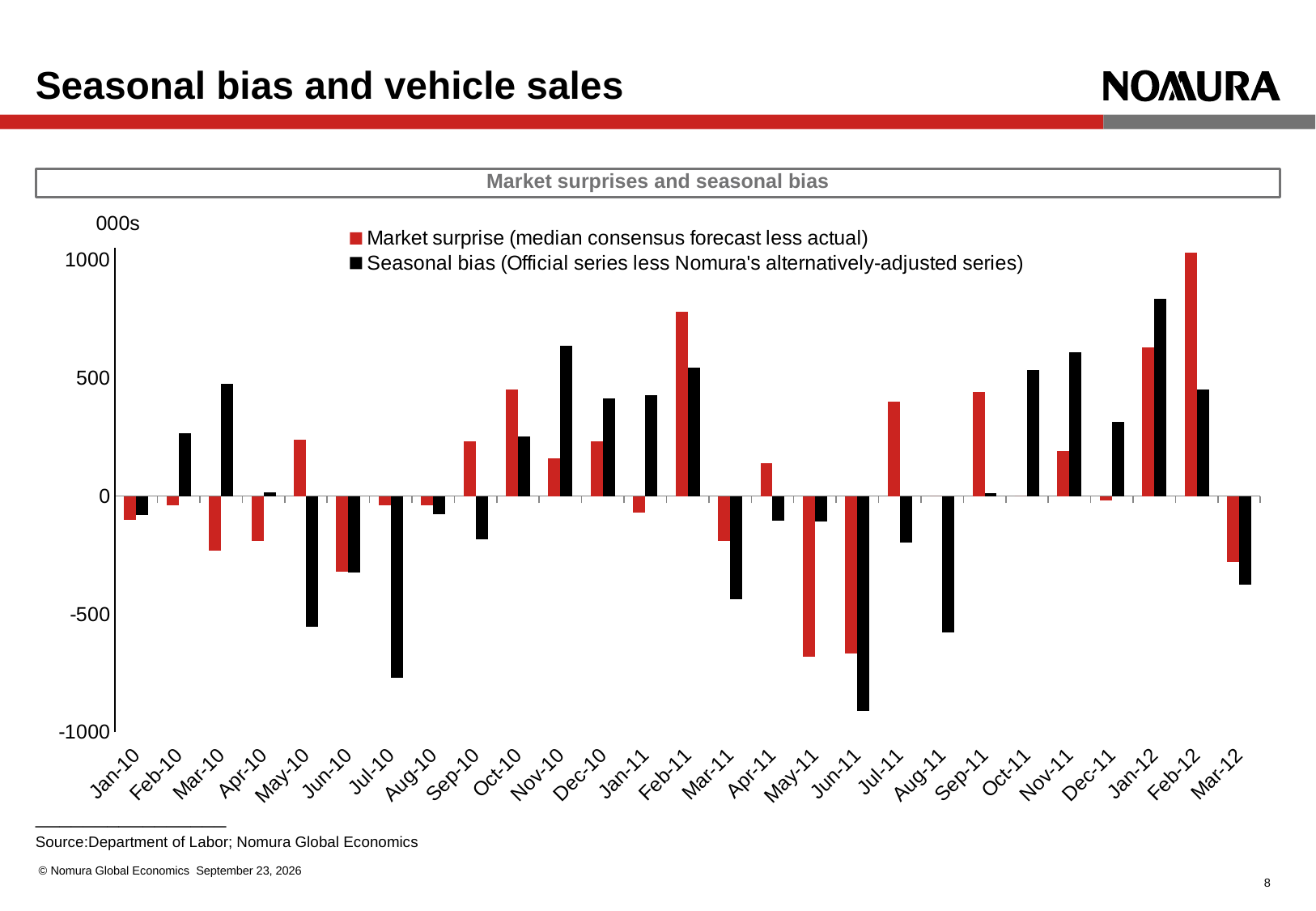
In Nov-10, which is larger: the Market surprise or the Seasonal bias? Seasonal bias What kind of chart is shown on the slide? Bar chart How many months are shown on the x axis? 27 In which month is the Seasonal bias value lowest? Jun-11 How many series does the legend list? 2 What unit label is shown at the top of the y axis? 000s In which month is the Seasonal bias value highest? Jan-12 In Feb-11, which is larger: the Market surprise or the Seasonal bias? Market surprise Is the Seasonal bias value for Jul-10 greater or less than -500? less Is the Seasonal bias value for Nov-10 greater or less than 500? greater In which month is the Market surprise value highest? Feb-12 Is the Market surprise value for Feb-11 greater or less than 500? greater